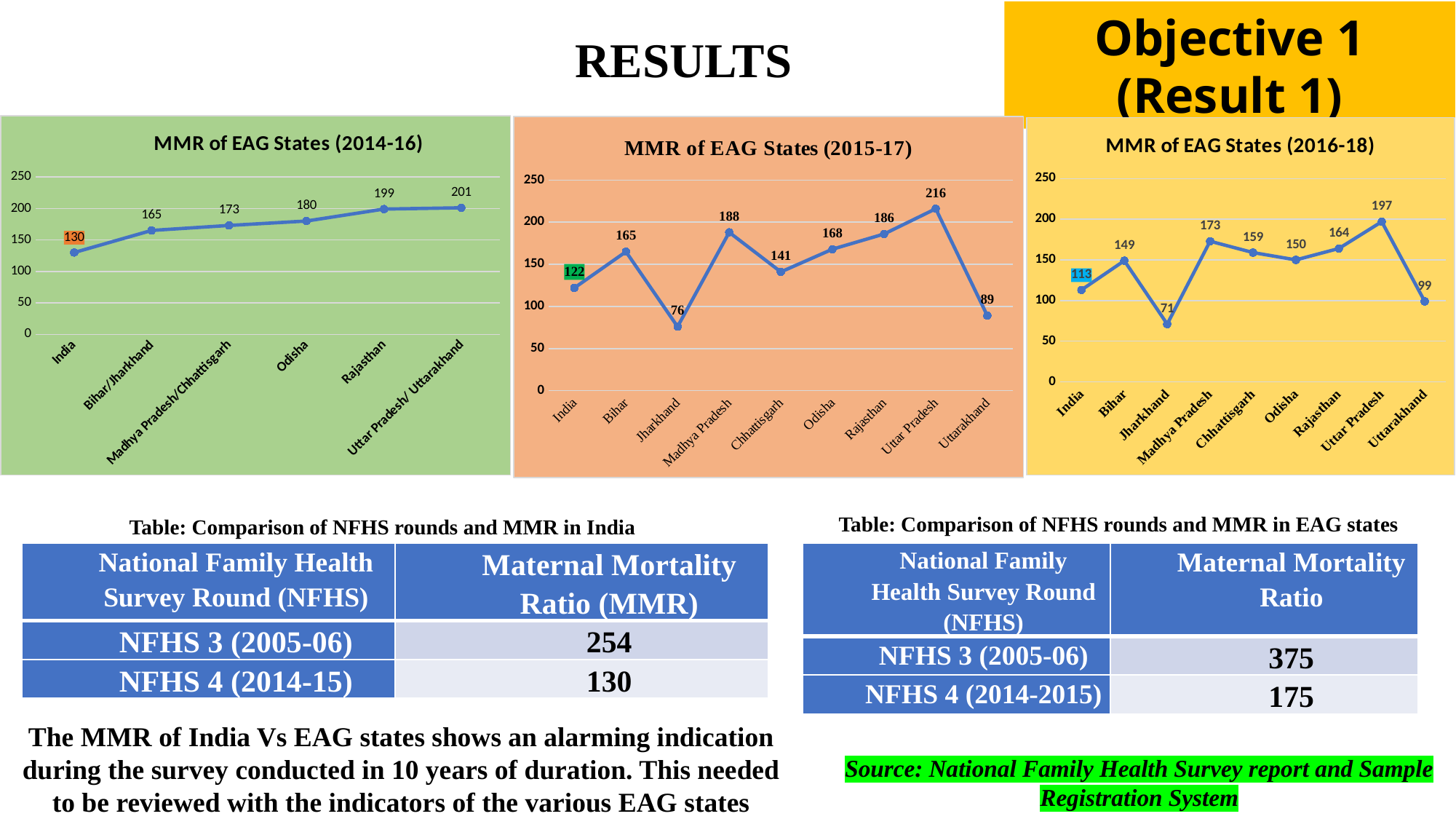
In the 'MMR of EAG States (2016-18)' chart, which is larger, Chhattisgarh or Odisha? Chhattisgarh In the 'MMR of EAG States (2015-17)' chart, what is the value for Uttar Pradesh? 216 In the 'MMR of EAG States (2014-16)' chart, which state has the highest MMR? Uttar Pradesh/ Uttarakhand In the 'MMR of EAG States (2014-16)' chart, do the values rise or fall from India to Uttar Pradesh/ Uttarakhand? rise In the 'MMR of EAG States (2015-17)' chart, which state has the lowest MMR? Jharkhand How many states are plotted in the 'MMR of EAG States (2016-18)' chart? 9 What kind of chart is 'MMR of EAG States (2015-17)'? line chart In the 'MMR of EAG States (2016-18)' chart, what is the difference between Uttar Pradesh and Uttarakhand? 98 In the 'MMR of EAG States (2016-18)' chart, what is the value for Rajasthan? 164 How many states or state groups are plotted in the 'MMR of EAG States (2014-16)' chart? 6 In the 'MMR of EAG States (2015-17)' chart, what is the difference between Madhya Pradesh and Chhattisgarh? 47 In the 'MMR of EAG States (2014-16)' chart, what is the value for Odisha? 180